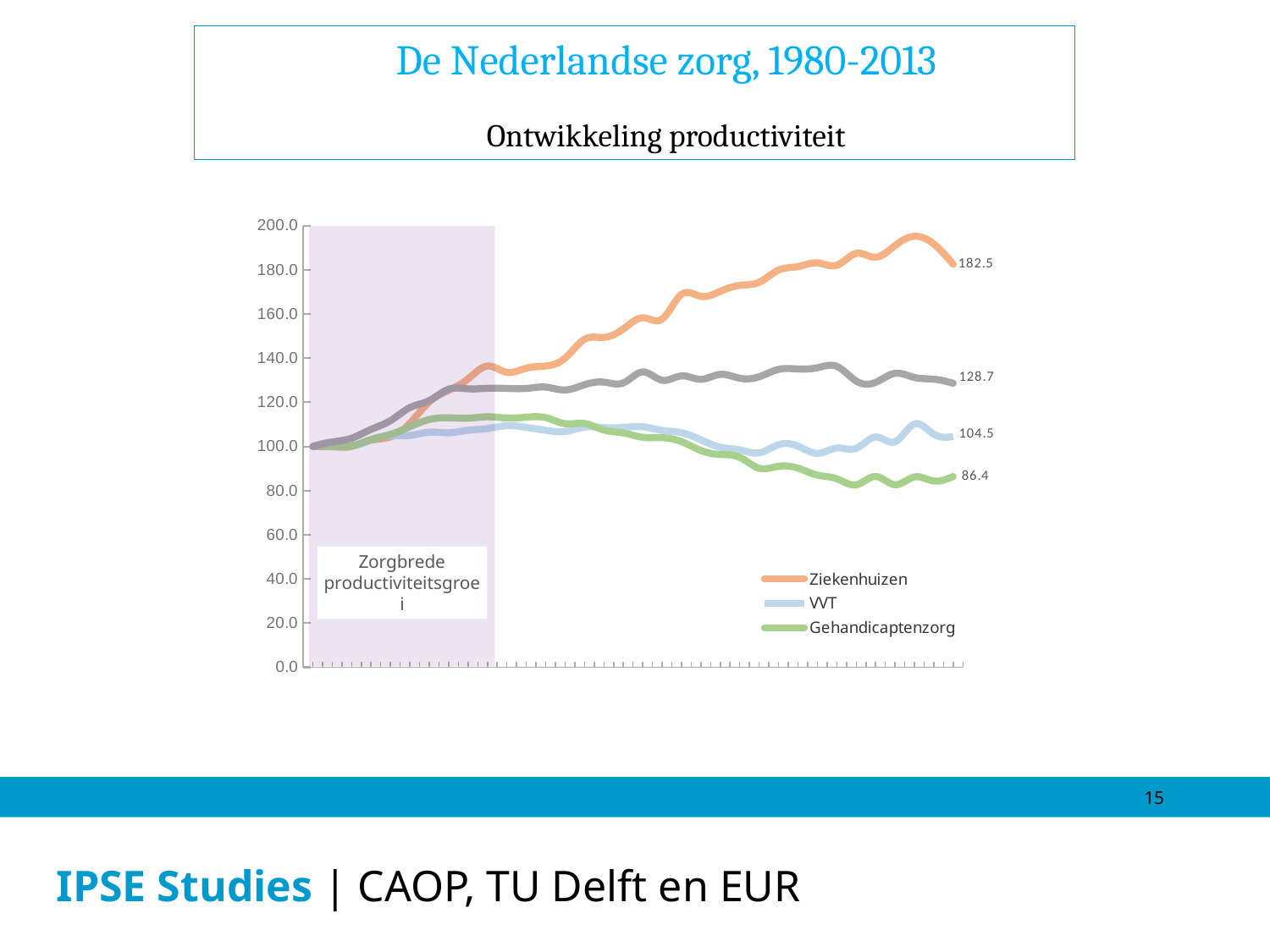
Which legend series ends at the highest value? Ziekenhuizen What is the final labelled value of the Ziekenhuizen series? 182.5 Is the peak value of the Ziekenhuizen series greater or less than 180? greater What is the final labelled value of the Gehandicaptenzorg series? 86.4 Which series ends higher, VVT or Gehandicaptenzorg? VVT What is the final labelled value of the VVT series? 104.5 What is the title shown above the chart? De Nederlandse zorg, 1980-2013 Does the Ziekenhuizen series rise or fall overall from left to right? rise What kind of chart is shown on the slide? line chart How many series does the legend list? 3 What is the difference between the final values of Ziekenhuizen (182.5) and Gehandicaptenzorg (86.4)? 96.1 Which legend series ends at the lowest value? Gehandicaptenzorg